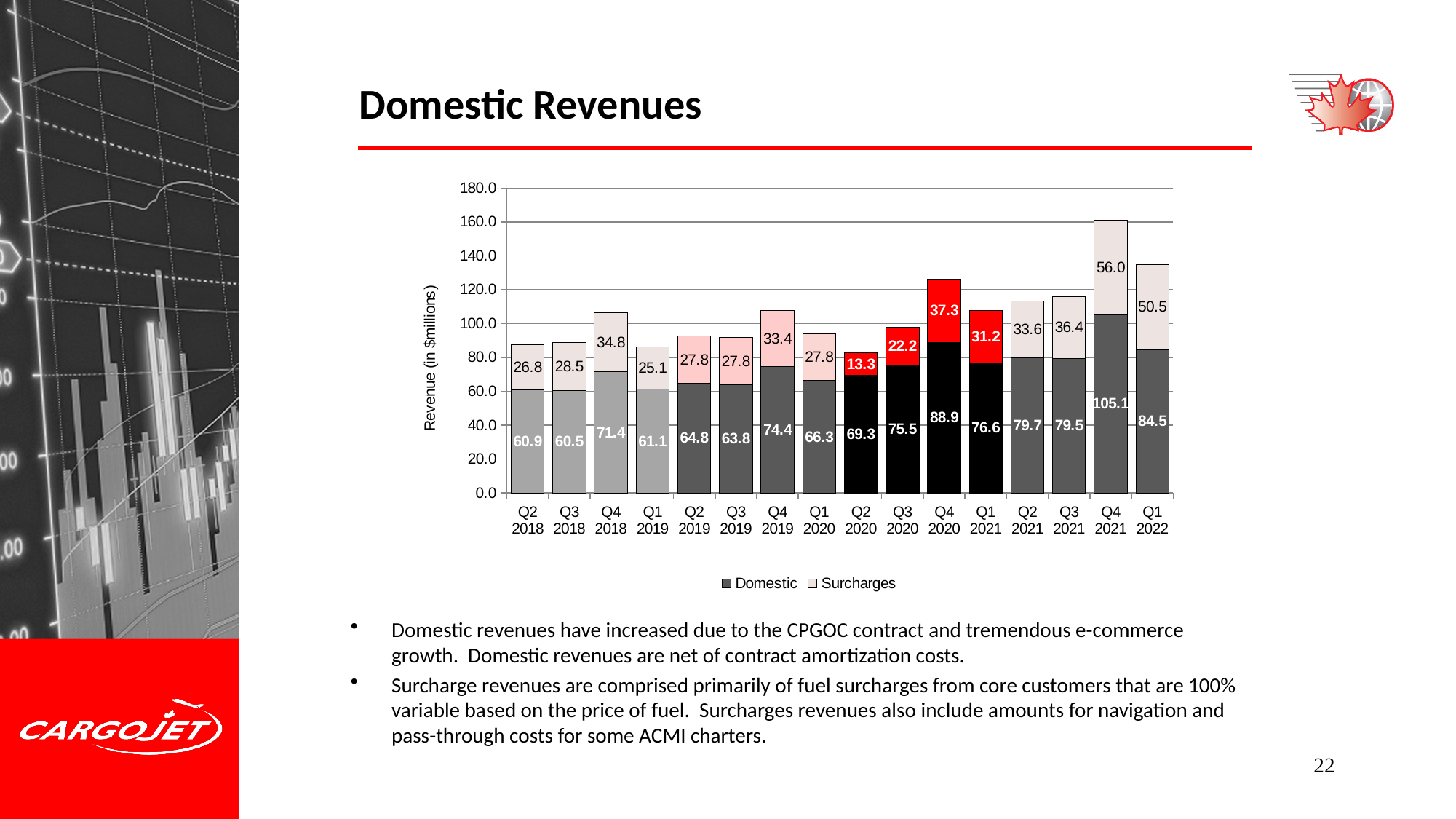
Which quarter has the lowest Surcharges value? Q2 2020 Which is larger, the Surcharges value for Q4 2021 or for Q1 2022? Q4 2021 Which quarter has the highest Domestic revenue? Q4 2021 What is the difference between the Domestic revenue in Q4 2021 and Q1 2022? 20.6 How many series does the legend list? 2 What is the Surcharges value for Q2 2020? 13.3 What is the total of the stacked bar for Q4 2021? 161.1 What is the Domestic revenue value for Q4 2021? 105.1 What kind of chart is shown on the slide? Stacked bar chart How many quarters are shown on the x axis? 16 What is the label on the y axis of the chart? Revenue (in $millions) Which quarter has the lowest Domestic revenue? Q3 2018